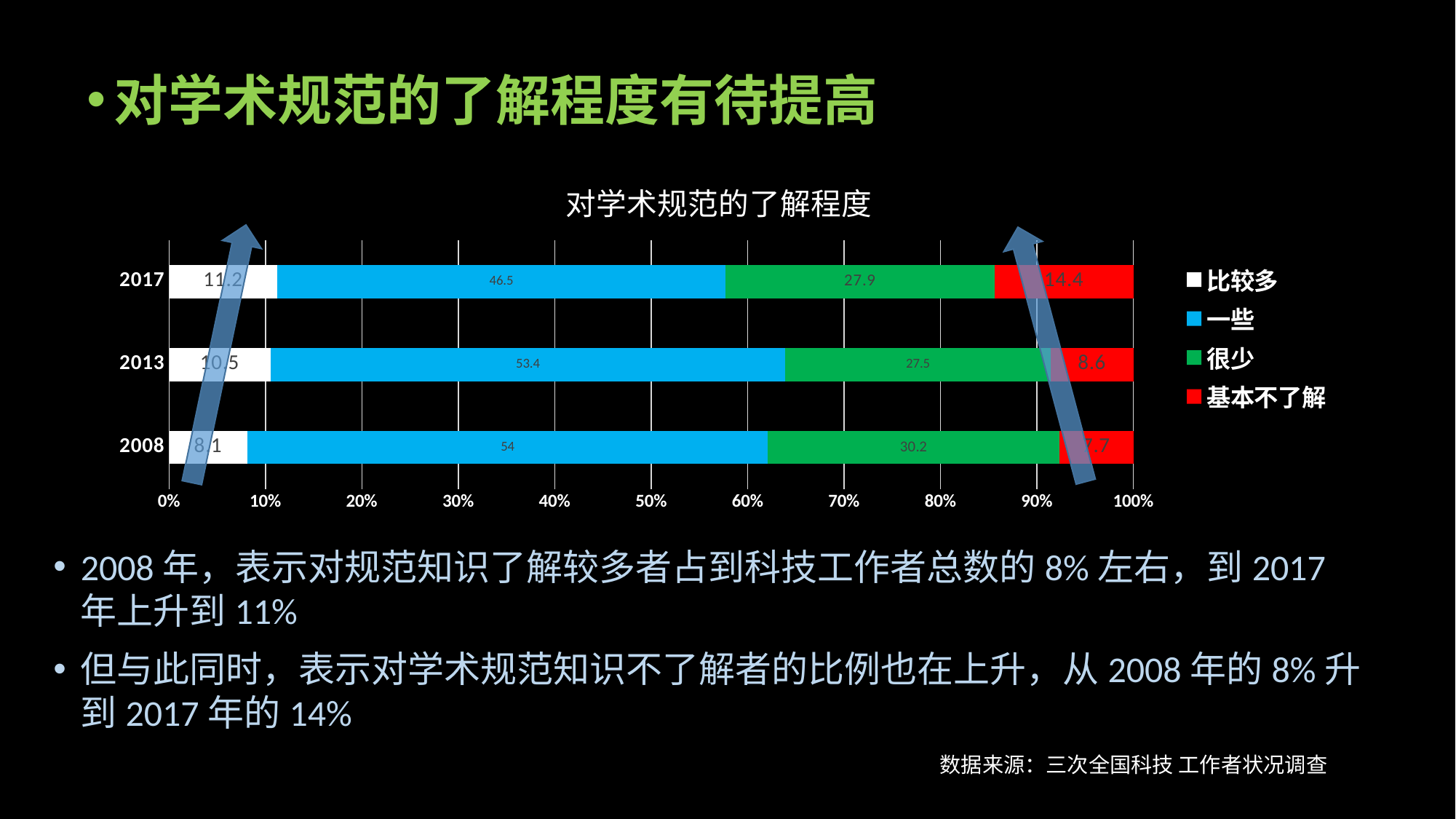
What is the title of the chart? 对学术规范的了解程度 What is the value of 一些 for 2017? 46.5 How many series does the legend list? 4 Which year has the highest value for 基本不了解? 2017 What is the value of 很少 for 2008? 30.2 What is the value of 基本不了解 for 2013? 8.6 Which year has the highest value for 一些? 2008 What is the difference between the 一些 values for 2013 and 2017? 6.9 Which is larger, the 很少 value for 2008 or for 2017? 2008 What kind of chart is shown? Stacked bar chart Does the value for 一些 rise or fall from 2008 to 2017? Fall How many years are shown on the chart? 3